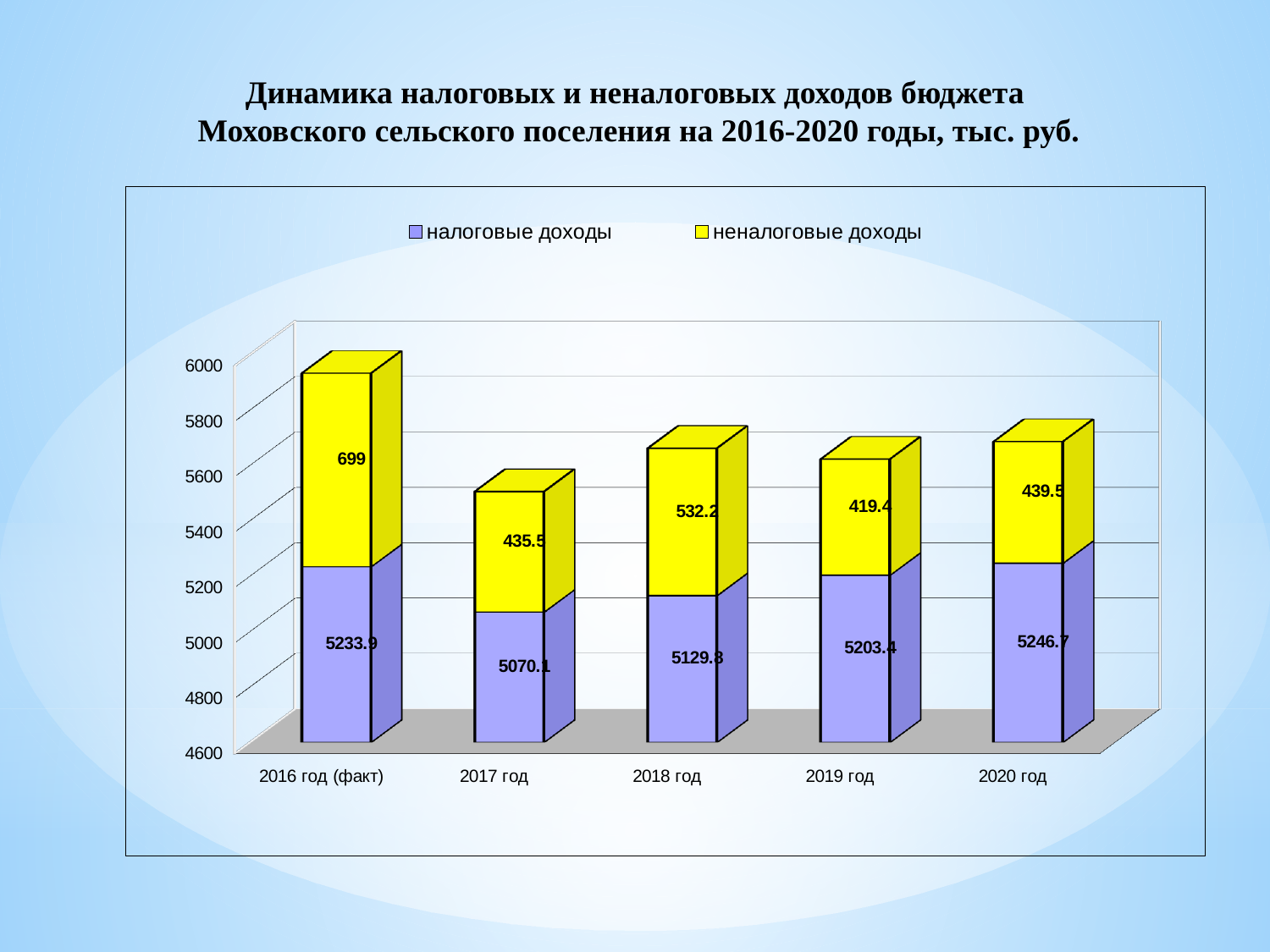
Which series is shown in yellow in the legend? неналоговые доходы What is the value of неналоговые доходы for 2019 год? 419.4 What is the difference between налоговые доходы in 2020 год and 2017 год? 176.6 What is the value of неналоговые доходы for 2016 год (факт)? 699 How many year categories are shown on the x axis? 5 How many series does the legend list? 2 Which is larger: неналоговые доходы in 2018 год or in 2020 год? 2018 год What is the total of the stacked bar for 2016 год (факт)? 5932.9 What is the value of налоговые доходы for 2017 год? 5070.1 Which year has the highest value of налоговые доходы? 2020 год Which year has the lowest value of неналоговые доходы? 2019 год What type of chart is shown on the slide? stacked bar chart